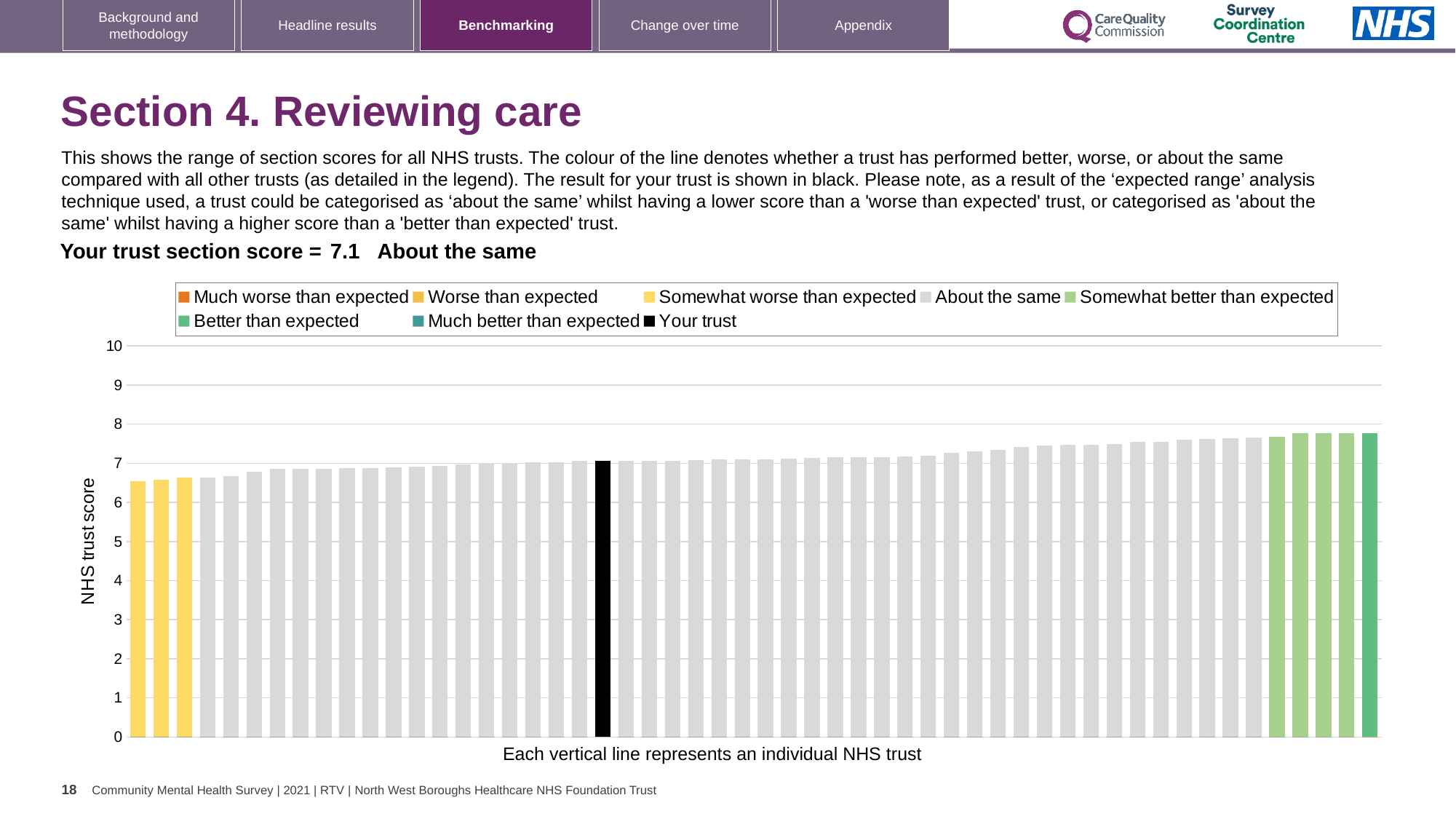
What colour is used for the bar representing your trust? Black How many entries does the chart legend list? 8 How many light green bars are shown near the right of the chart? 4 Is the value of the lowest bar in the chart greater or less than 6? greater Is the value of the highest bar in the chart greater or less than 8? less How many yellow bars are shown at the left of the chart? 3 Do the bar values rise or fall from left to right along the x axis? rise What type of chart is shown on the slide? Bar chart Is the value for your trust (the black bar) greater or less than 5? greater What is the section score for your trust? 7.1 Which performance category is your trust placed in for this section? About the same What is the label on the y axis of the chart? NHS trust score